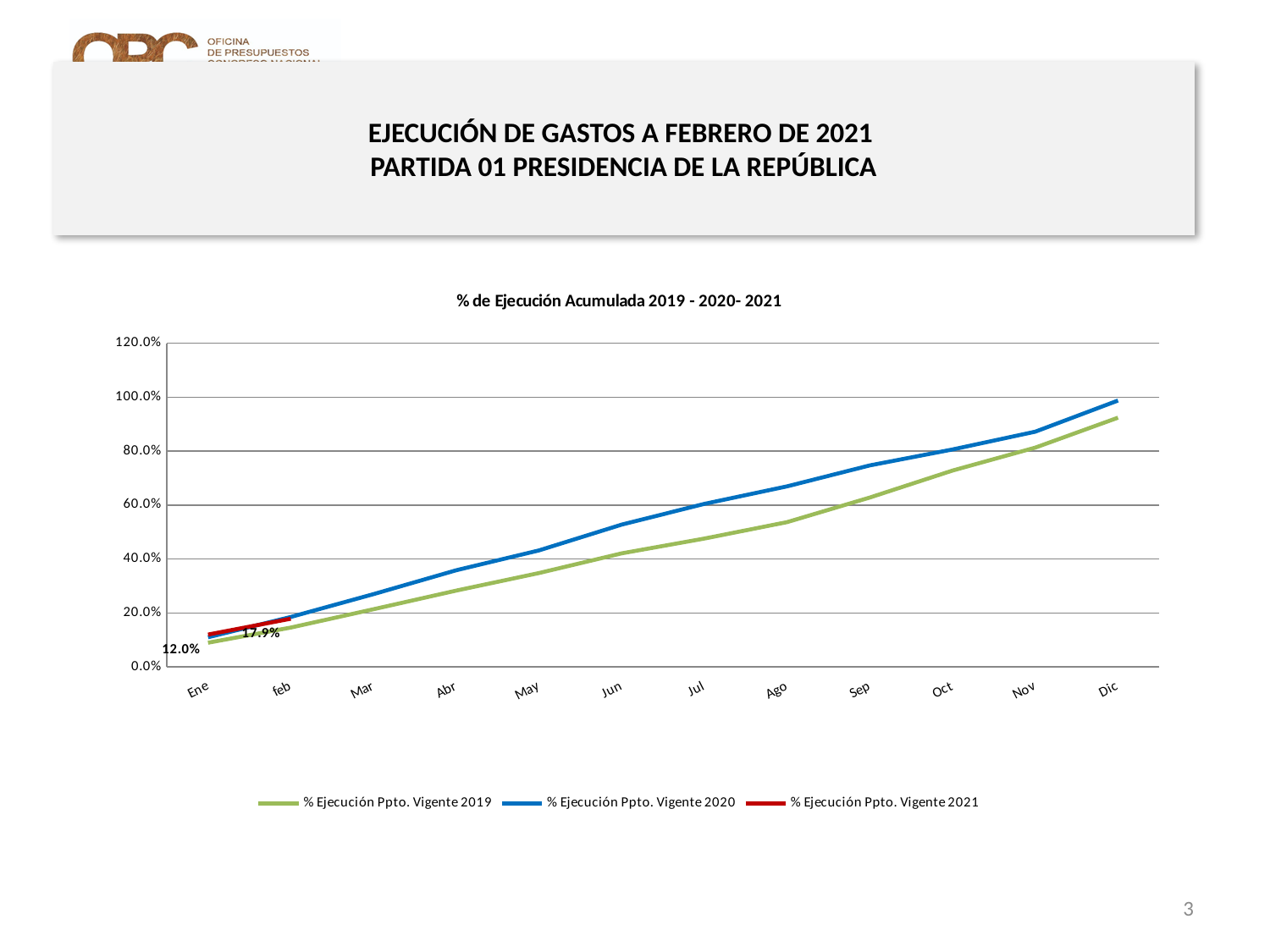
Does the % Ejecución Ppto. Vigente 2020 line rise or fall from Ene to Dic? rise In which month does % Ejecución Ppto. Vigente 2019 reach its highest value? Dic What kind of chart is shown on the slide? line chart What is the value of % Ejecución Ppto. Vigente 2021 in Ene? 12.0% What is the title of the chart? % de Ejecución Acumulada 2019 - 2020- 2021 In Dic, which series is higher: % Ejecución Ppto. Vigente 2019 or % Ejecución Ppto. Vigente 2020? % Ejecución Ppto. Vigente 2020 By how much did % Ejecución Ppto. Vigente 2021 increase from Ene to Feb? 5.9% How many series does the legend list? 3 How many months are shown along the x axis? 12 What is the value of % Ejecución Ppto. Vigente 2021 in Feb? 17.9% Is the value for % Ejecución Ppto. Vigente 2020 in Dic greater or less than 80.0%? greater Is the value for % Ejecución Ppto. Vigente 2019 in Jun greater or less than 60.0%? less